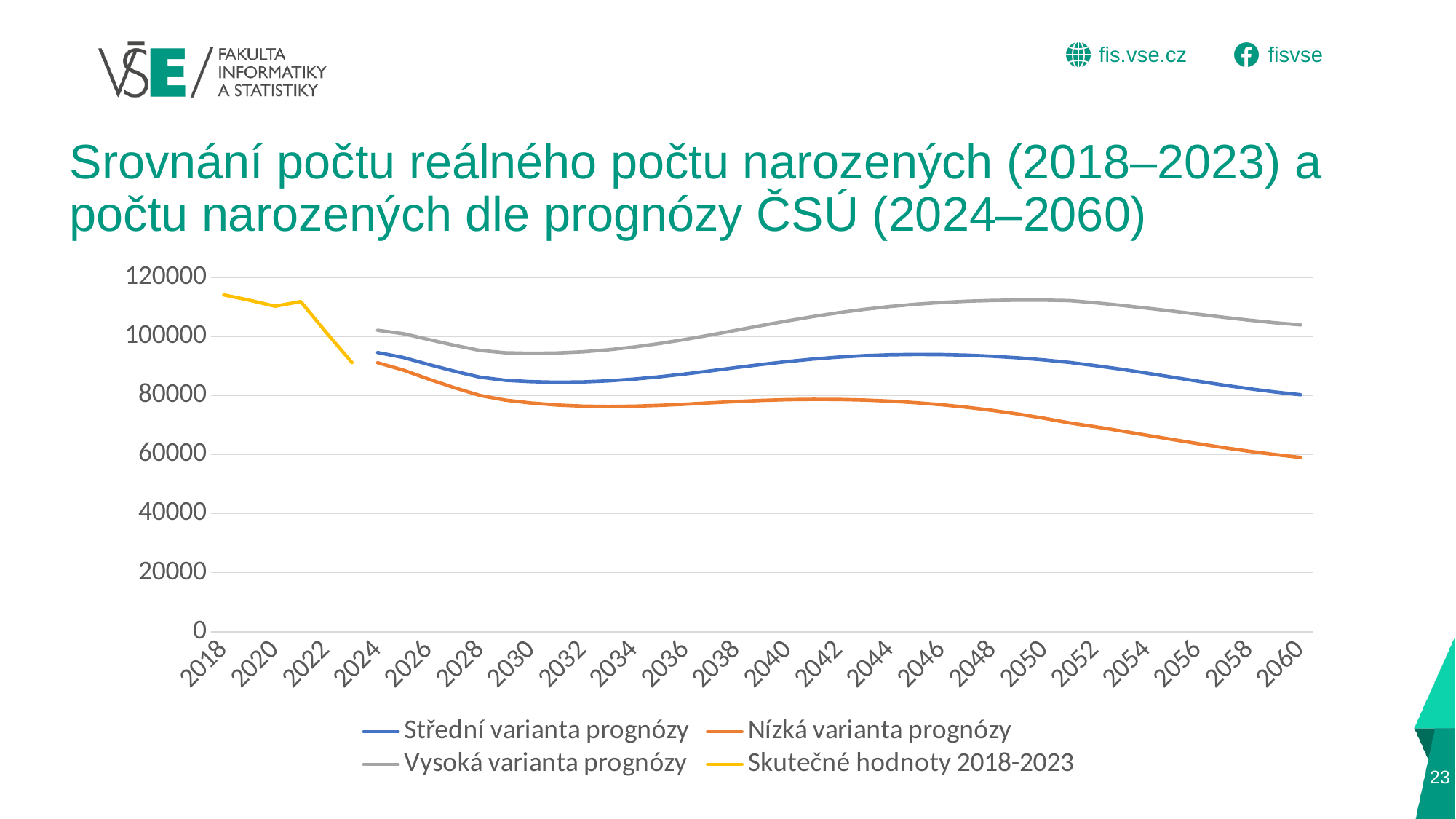
What kind of chart is shown on the slide? line chart What colour is the line for Skutečné hodnoty 2018-2023? yellow Is the value of Vysoká varianta prognózy in 2050 greater or less than 100000? greater Which series has the lowest value in 2030? Nízká varianta prognózy Is the value of Nízká varianta prognózy in 2060 greater or less than 80000? less Does the Nízká varianta prognózy line rise or fall from 2046 to 2060? fall How many series does the legend list? 4 Is the value of Střední varianta prognózy in 2030 greater or less than 100000? less Does the Skutečné hodnoty 2018-2023 line rise or fall from 2018 to 2023? fall Which series has the highest value in 2040? Vysoká varianta prognózy In 2060, which is larger: Střední varianta prognózy or Nízká varianta prognózy? Střední varianta prognózy